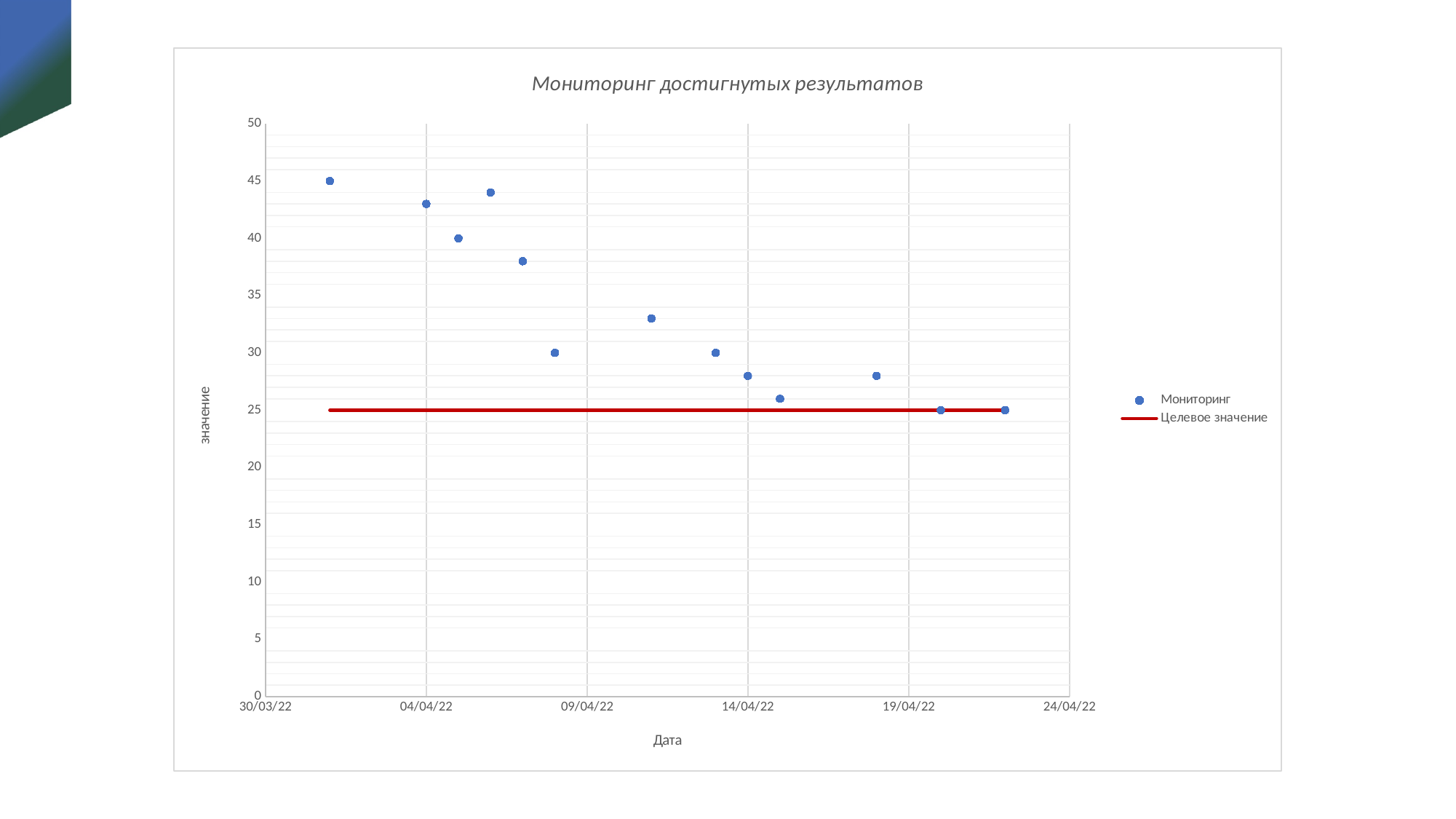
What are the two entries in the chart legend? Мониторинг, Целевое значение How many series does the legend list? 2 Is the Мониторинг value on 14/04/22 greater or less than 30? less How many Мониторинг data points are plotted on the chart? 13 Is the Мониторинг value on 04/04/22 greater or less than 40? greater What kind of chart is shown on the slide? scatter chart What is the title of the chart? Мониторинг достигнутых результатов Which is larger, the Мониторинг value on 04/04/22 or on 14/04/22? 04/04/22 What is the label of the x axis? Дата Is the Целевое значение line above or below 30 on the y axis? below Do the Мониторинг values generally rise or fall over time along the x axis? fall